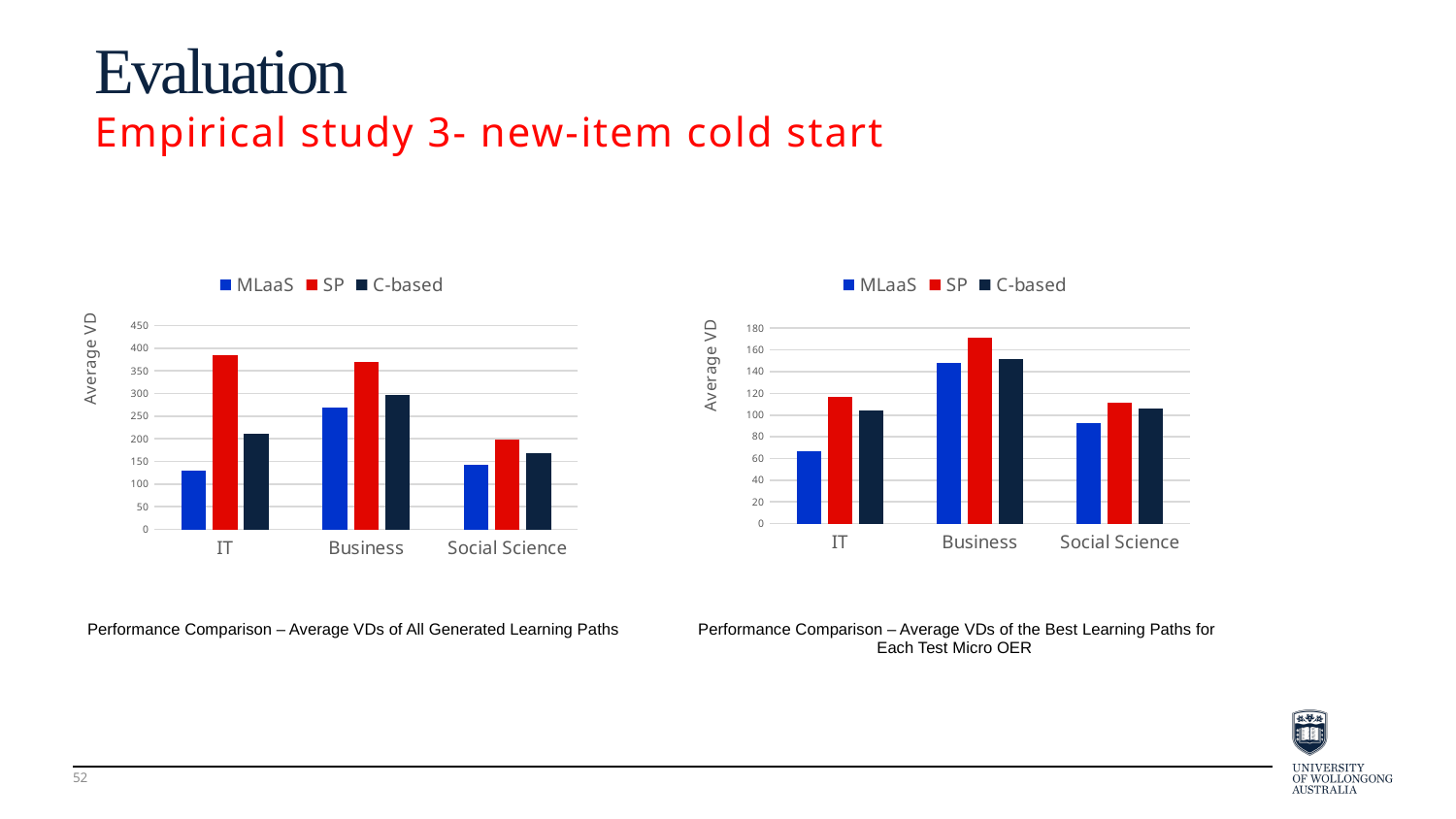
In the left chart (Average VDs of All Generated Learning Paths), which series has the lowest value for Business? MLaaS In the left chart (Average VDs of All Generated Learning Paths), how many series does the legend list? 3 In the right chart (Average VDs of the Best Learning Paths for Each Test Micro OER), how many categories are shown on the x axis? 3 In the right chart (Average VDs of the Best Learning Paths for Each Test Micro OER), which series has the lowest value for IT? MLaaS What is the label of the y axis on the left chart (Average VDs of All Generated Learning Paths)? Average VD In the left chart (Average VDs of All Generated Learning Paths), is the MLaaS value for Social Science greater or less than 200? less In the left chart (Average VDs of All Generated Learning Paths), is the SP value for IT greater or less than 350? greater In the right chart (Average VDs of the Best Learning Paths for Each Test Micro OER), is the MLaaS value for IT greater or less than 80? less In the left chart (Average VDs of All Generated Learning Paths), what kind of chart is shown? Bar chart In the right chart (Average VDs of the Best Learning Paths for Each Test Micro OER), which is larger for Social Science: the MLaaS value or the SP value? SP In the left chart (Average VDs of All Generated Learning Paths), which series has the highest value for IT? SP In the right chart (Average VDs of the Best Learning Paths for Each Test Micro OER), which category has the highest SP value? Business